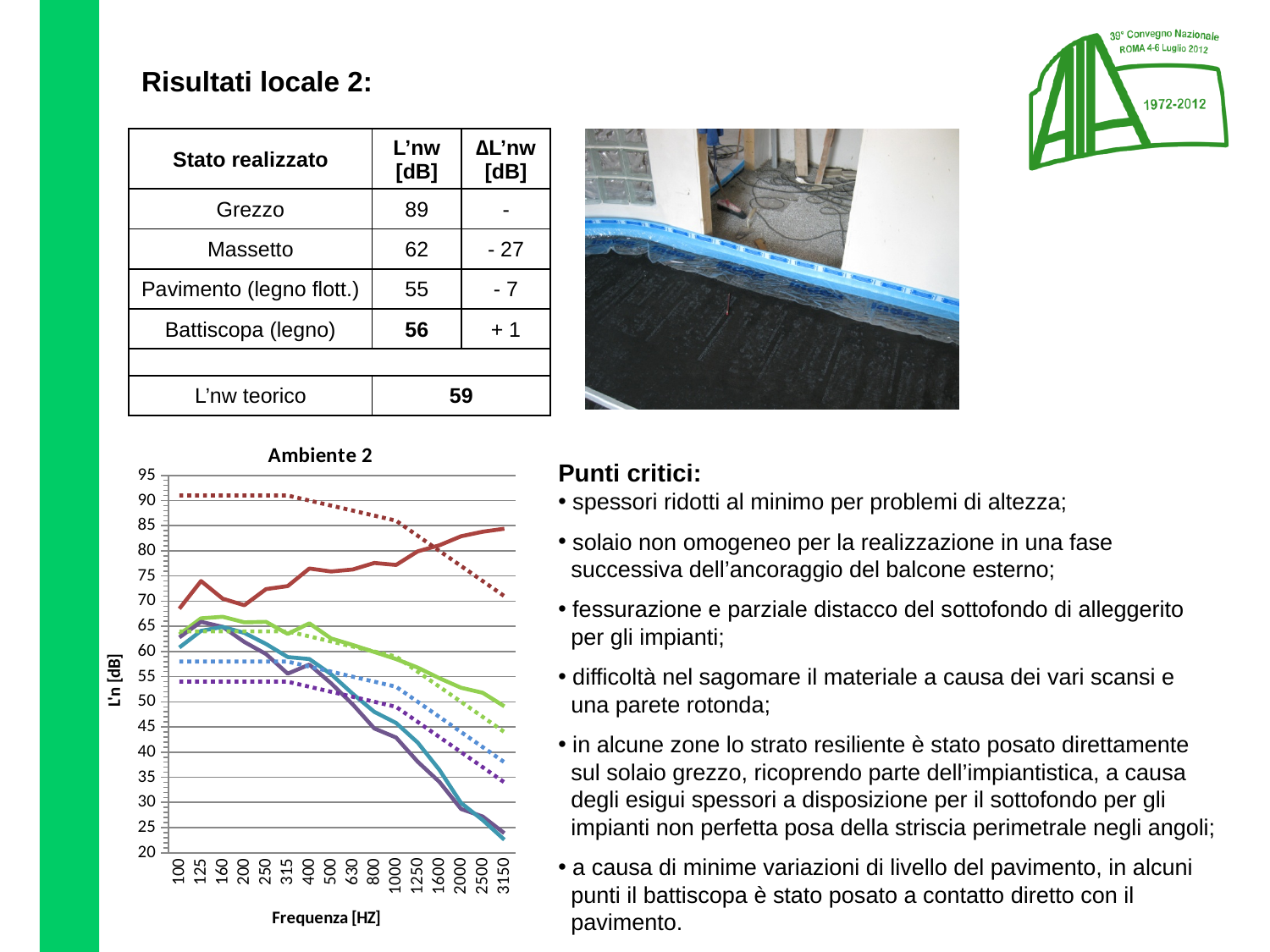
In the "Ambiente 2" chart, is the value of the solid green line at 100 Hz greater or less than 60? greater In the "Ambiente 2" chart, is the value of the solid purple line at 3150 Hz greater or less than 30? less In the "Ambiente 2" chart, does the solid green line rise or fall overall from 100 Hz to 3150 Hz? fall How many frequency categories are shown on the x axis of the "Ambiente 2" chart? 16 In the "Ambiente 2" chart, which line has the highest value at 3150 Hz? the solid red line In the "Ambiente 2" chart, does the solid red line rise or fall overall from 100 Hz to 3150 Hz? rise What is the title of the chart on the slide? Ambiente 2 What kind of chart is shown under the title "Ambiente 2"? line chart In the "Ambiente 2" chart, is the value of the dotted blue line at 100 Hz greater or less than 55? greater What is the label of the x axis of the "Ambiente 2" chart? Frequenza [HZ]